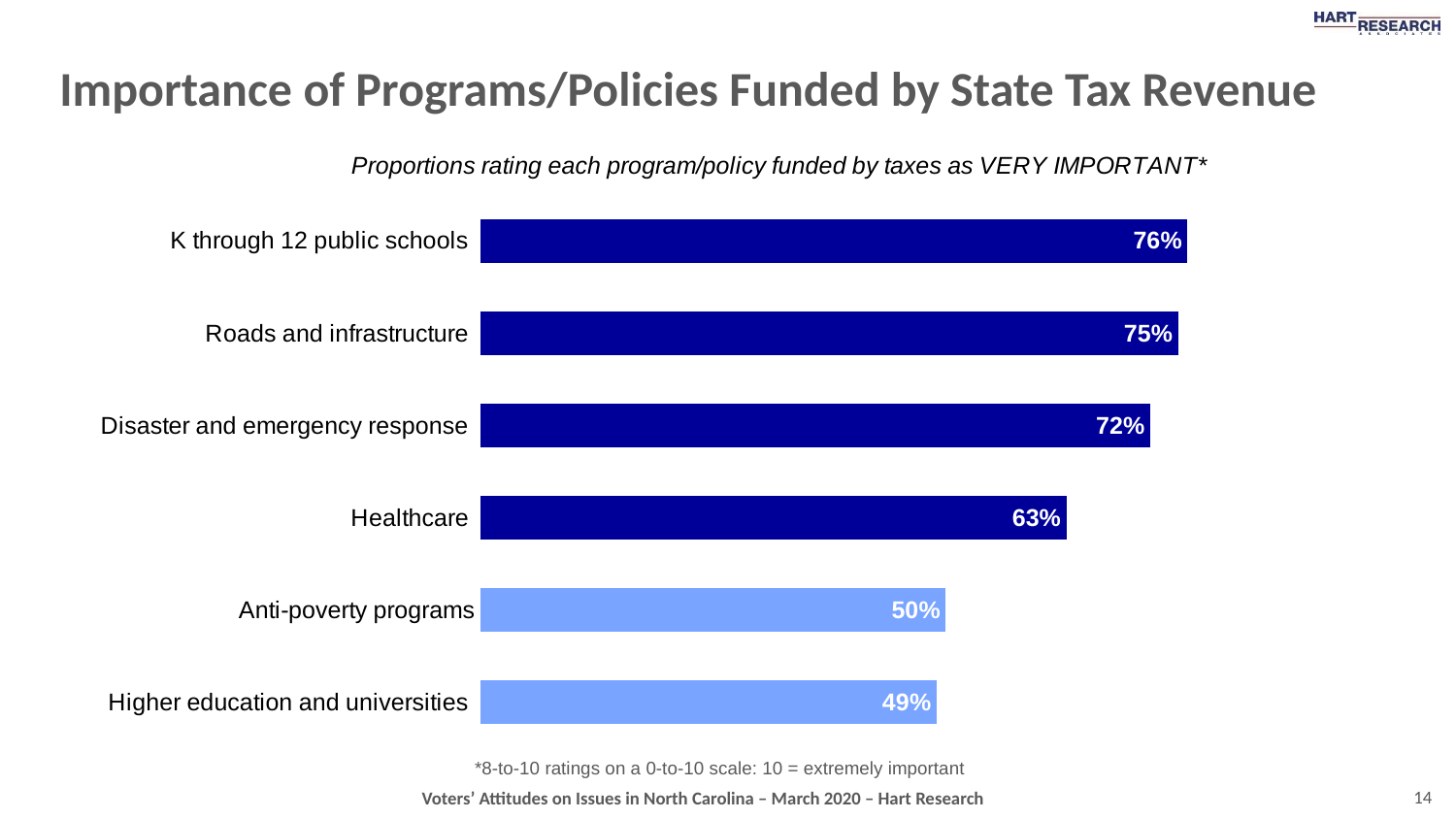
What kind of chart is shown on the slide? Bar chart What is the difference between the values for Disaster and emergency response and Healthcare? 9 percentage points Which program/policy has the lowest proportion rating it as very important? Higher education and universities Which has a larger value, Roads and infrastructure or Healthcare? Roads and infrastructure Which program/policy has the highest proportion rating it as very important? K through 12 public schools What is the value shown for Healthcare? 63% How many programs/policies are shown in the chart? 6 What percentage is shown for Higher education and universities? 49% What percentage rated K through 12 public schools as very important? 76% What is the difference between the values for K through 12 public schools and Anti-poverty programs? 26 percentage points Which bars are shown in a lighter blue colour? Anti-poverty programs and Higher education and universities What is the title of the slide's chart? Importance of Programs/Policies Funded by State Tax Revenue